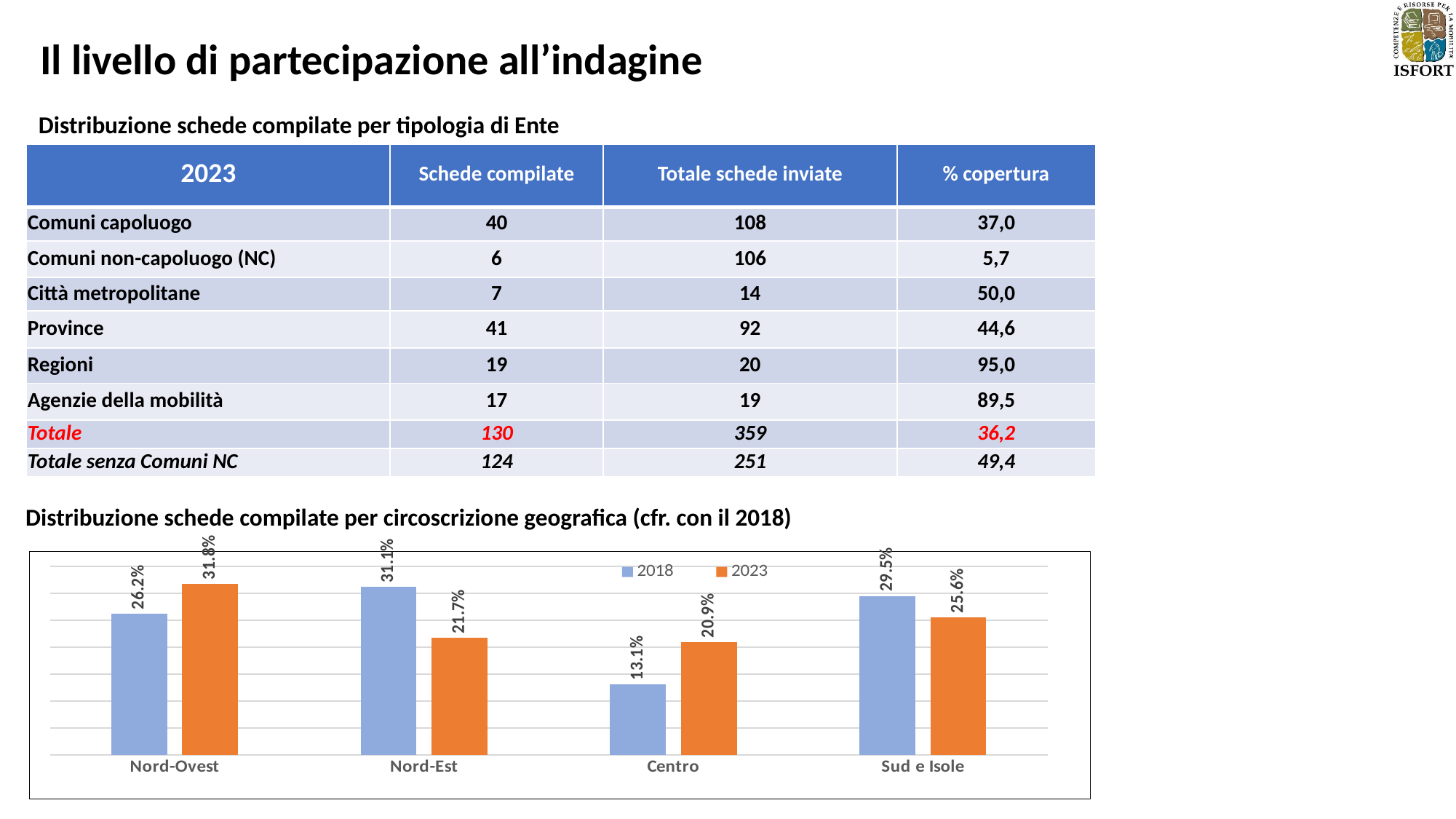
For Sud e Isole, which is larger: the 2018 value or the 2023 value? 2018 What is the 2023 value for Nord-Ovest in the chart? 31.8% How many geographic regions are shown on the x axis of the chart? 4 What is the difference between the 2023 and 2018 values for Centro? 7.8 percentage points What is the 2023 value for Sud e Isole in the chart? 25.6% What is the difference between the 2018 and 2023 values for Nord-Est? 9.4 percentage points Which region has the lowest 2018 value in the chart? Centro How many series does the chart legend list? 2 What is the 2018 value for Centro in the chart? 13.1% Which region has the highest 2018 value in the chart? Nord-Est Which region has the lowest 2023 value in the chart? Centro What type of chart is shown at the bottom of the slide? Bar chart